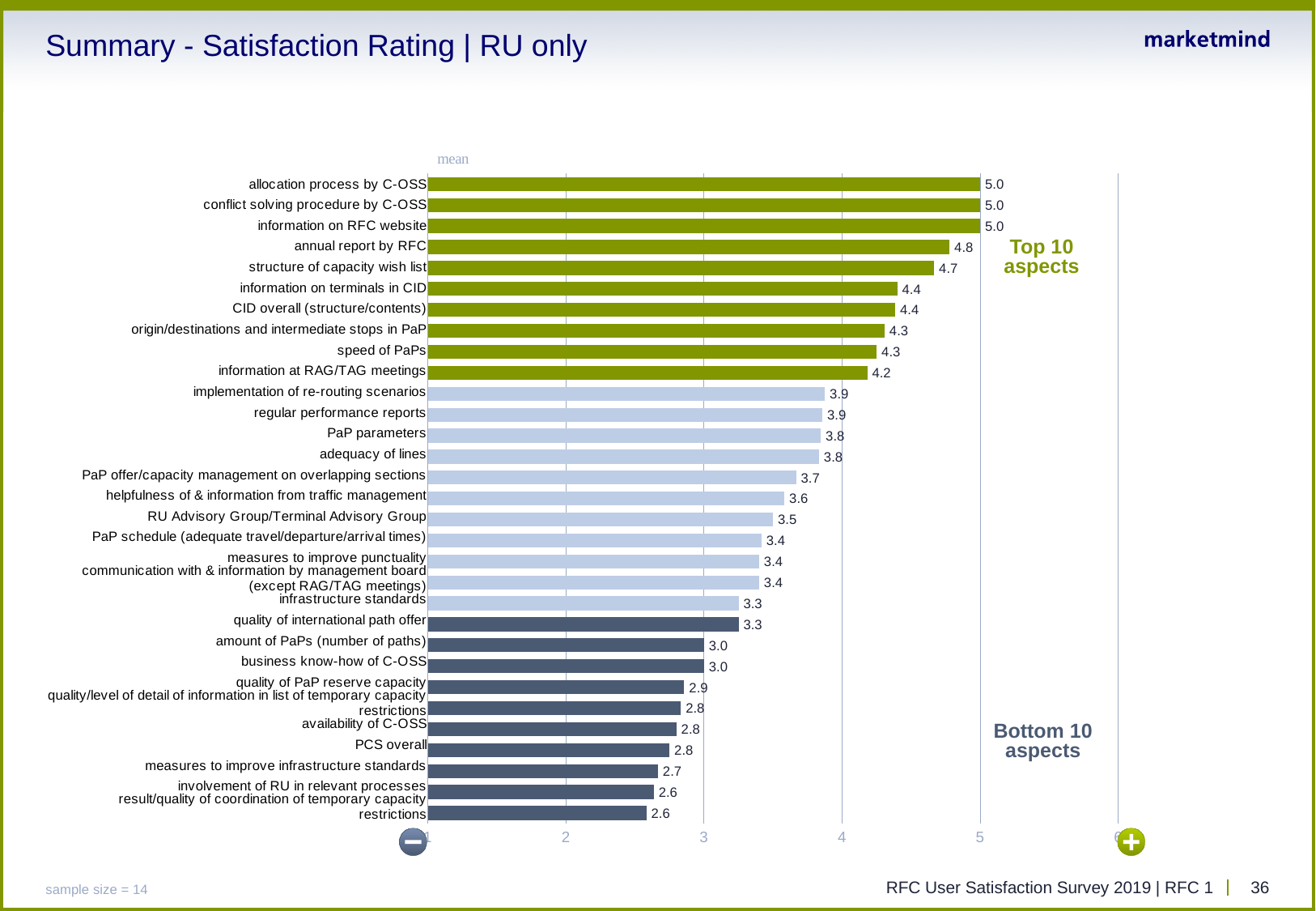
What is the mean satisfaction rating for RU Advisory Group/Terminal Advisory Group? 3.5 What type of chart is shown on the slide? bar chart What is the mean satisfaction rating for PCS overall? 2.8 What is the mean satisfaction rating for annual report by RFC? 4.8 What is the mean satisfaction rating for speed of PaPs? 4.3 Which aspect has the lowest mean rating shown at the bottom of the chart? result/quality of coordination of temporary capacity restrictions What is the difference between the mean rating for structure of capacity wish list and the mean rating for measures to improve infrastructure standards? 2.0 What is the highest mean rating value shown on the chart? 5.0 What is the mean satisfaction rating for business know-how of C-OSS? 3.0 What is the sample size stated on the slide? 14 Which has a higher mean rating: information at RAG/TAG meetings or adequacy of lines? information at RAG/TAG meetings Is the mean rating for quality of PaP reserve capacity greater or less than 3? less